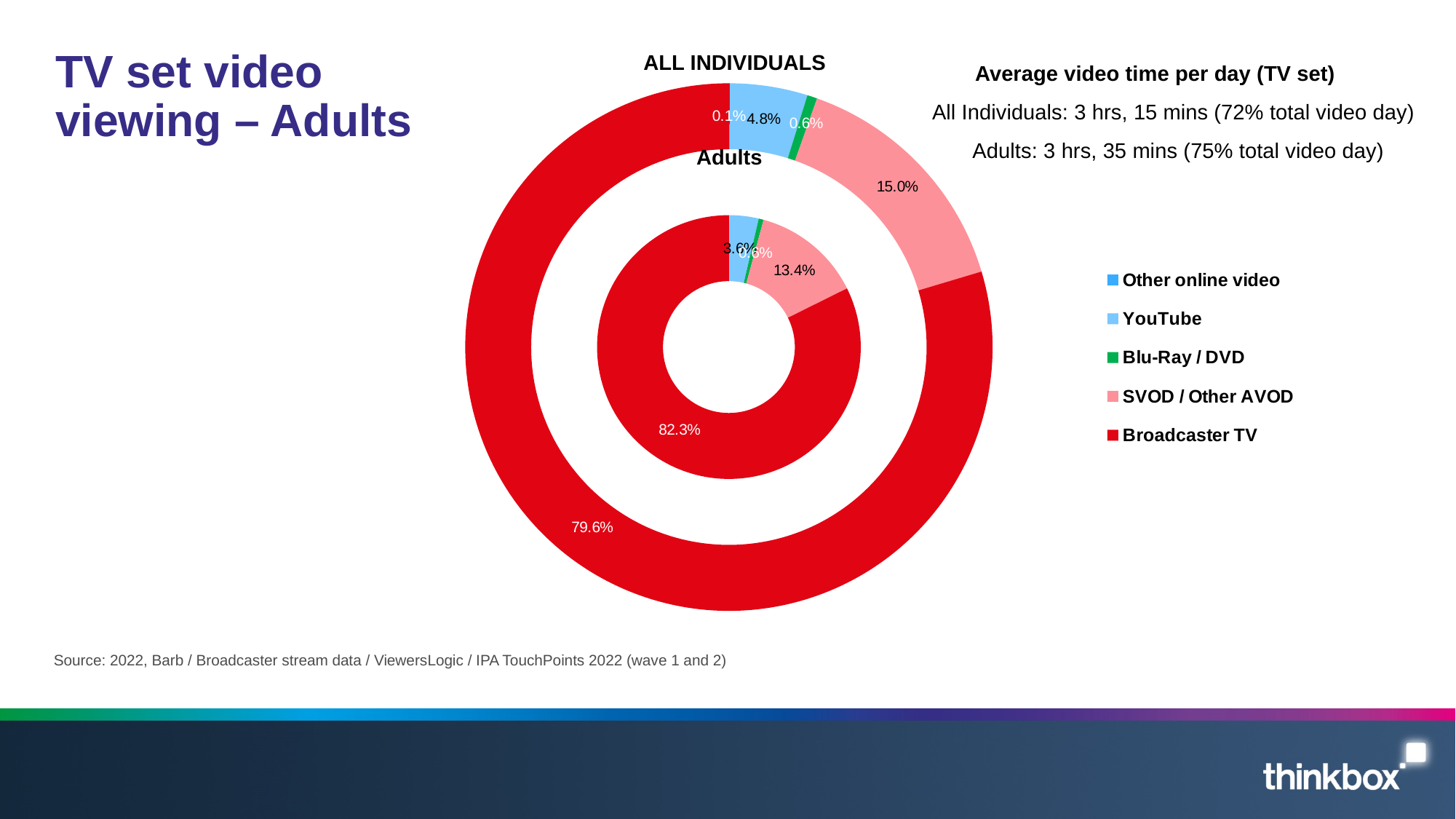
How many percentage points higher is the Broadcaster TV share for Adults than for ALL INDIVIDUALS? 2.7 percentage points In the ALL INDIVIDUALS ring, what share is YouTube? 4.8% In the ALL INDIVIDUALS ring, what share of TV set video viewing is Broadcaster TV? 79.6% In the ALL INDIVIDUALS ring, what share is Other online video? 0.1% In the Adults ring, what share of TV set video viewing is Broadcaster TV? 82.3% In the ALL INDIVIDUALS ring, what share is SVOD / Other AVOD? 15.0% How many categories does the legend list? 5 Which category has the largest share in the Adults ring? Broadcaster TV In the Adults ring, what share is SVOD / Other AVOD? 13.4% Which category has the smallest share in the ALL INDIVIDUALS ring? Other online video What kind of chart is shown on the slide? Doughnut chart In the Adults ring, what share is YouTube? 3.6%